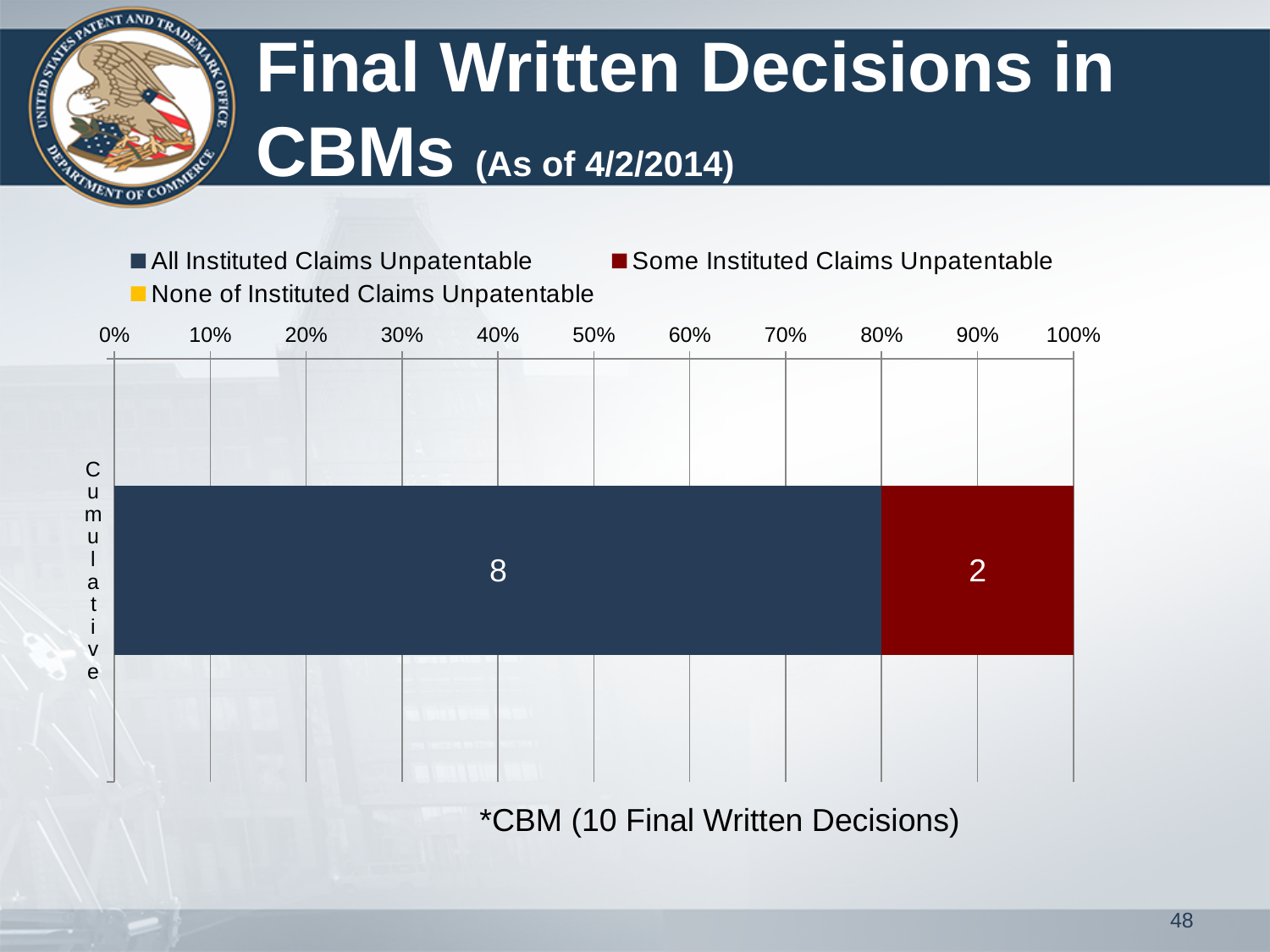
What is the value for Some Instituted Claims Unpatentable in the Cumulative bar? 2 Which series has the highest value in the Cumulative bar? All Instituted Claims Unpatentable What colour represents Some Instituted Claims Unpatentable in the legend? Dark red What kind of chart is shown on the slide? Stacked bar chart What is the total of the labelled segments in the Cumulative bar? 10 Which is larger: All Instituted Claims Unpatentable or Some Instituted Claims Unpatentable? All Instituted Claims Unpatentable What is the difference between the All Instituted Claims Unpatentable value and the Some Instituted Claims Unpatentable value? 6 How many series does the legend list? 3 Does the All Instituted Claims Unpatentable segment end at a share greater or less than 70%? greater How many categories are plotted on the chart? 1 What is the category label on the vertical axis? Cumulative What is the value for All Instituted Claims Unpatentable in the Cumulative bar? 8